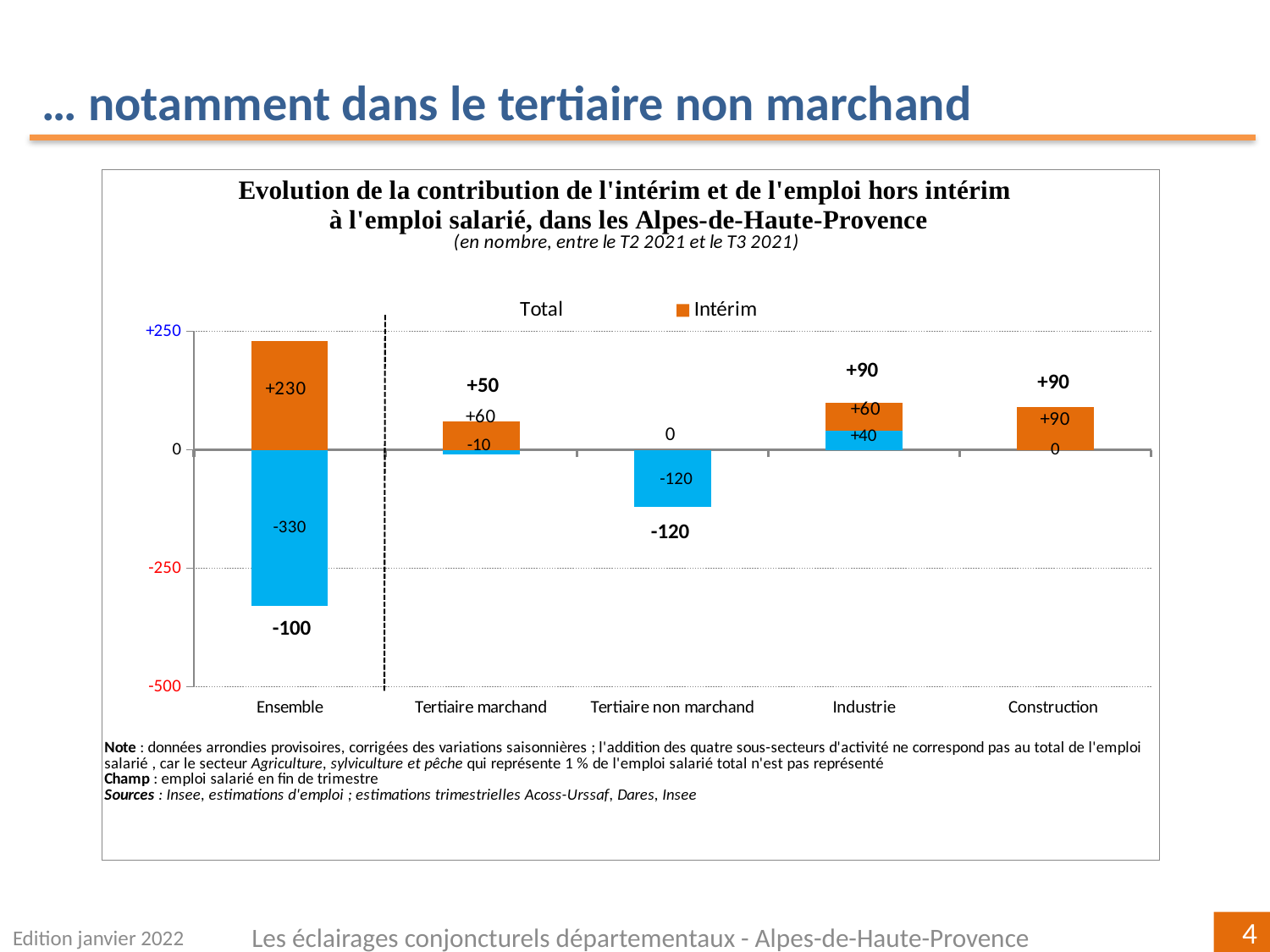
What is the Intérim value for Ensemble? +230 What is the Intérim value for Tertiaire non marchand? 0 How many entries does the chart's legend list? 2 How many categories are shown on the x axis of the chart? 5 Which has the larger Intérim value, Industrie or Construction? Construction Which category has the highest Intérim value? Ensemble What kind of chart is shown on the slide? bar chart What is the Total value shown for Tertiaire non marchand? -120 What is the difference between the Intérim value for Ensemble and the Intérim value for Construction? 140 What is the Intérim value for Construction? +90 What is the Total value shown for Ensemble? -100 Which category has the lowest Total value? Tertiaire non marchand